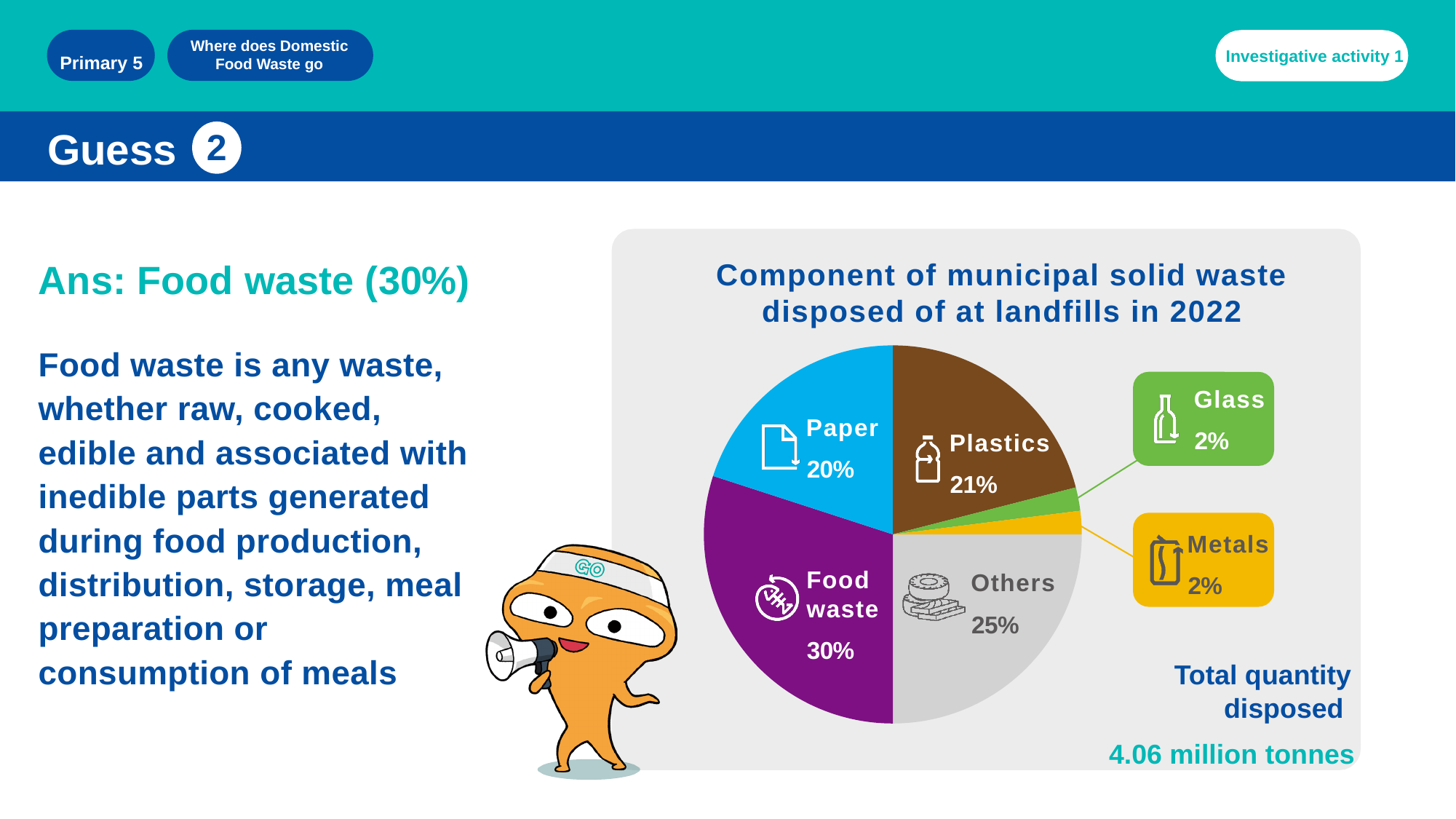
What percentage of the waste is Glass? 2% What type of chart is shown on the slide? Pie chart What is the title of the chart? Component of municipal solid waste disposed of at landfills in 2022 What percentage does the Paper slice represent? 20% What share of the pie chart is Plastics? 21% What total quantity of waste disposed is stated next to the chart? 4.06 million tonnes Which is larger, the share for Plastics or the share for Paper? Plastics What is the difference in percentage points between Food waste and Others? 5 Which component has the largest share of the pie chart? Food waste How many components are shown in the pie chart? 6 What is the combined share of Glass and Metals? 4% What percentage of municipal solid waste disposed of at landfills in 2022 is food waste? 30%